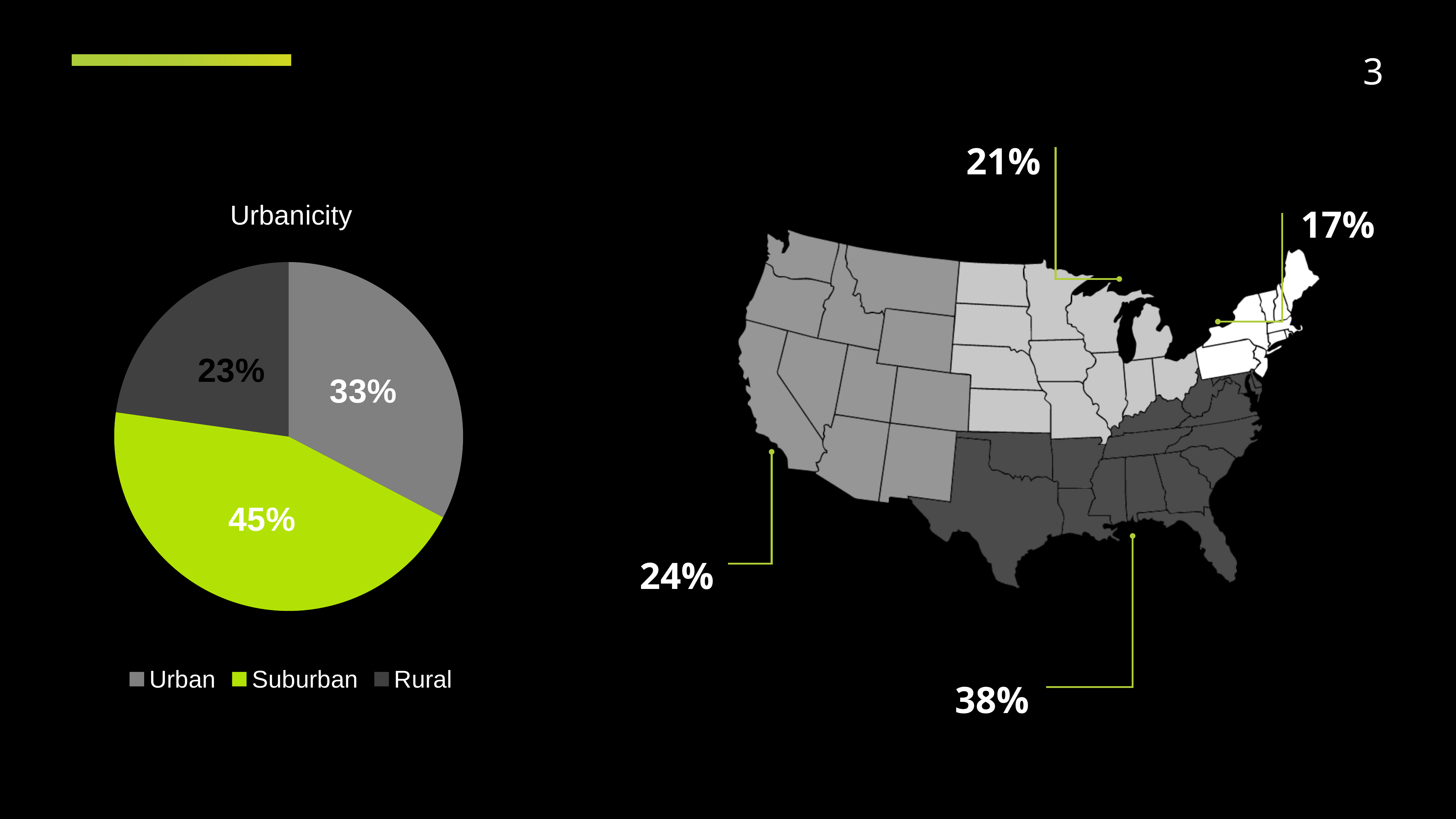
In the Urbanicity pie chart, which category is shown in green? Suburban In the Urbanicity pie chart, what percentage is Rural? 23% In the Urbanicity pie chart, what is the difference in percentage points between Suburban and Urban? 12 In the Urbanicity pie chart, what percentage is Suburban? 45% What type of chart is the Urbanicity chart? Pie chart In the Urbanicity pie chart, which is larger, Urban or Rural? Urban On the map on the right of the slide, what is the highest percentage shown? 38% How many slices does the Urbanicity pie chart have? 3 In the Urbanicity pie chart, what percentage is Urban? 33% In the Urbanicity pie chart, which category has the smallest share? Rural In the Urbanicity pie chart, what is the difference in percentage points between Urban and Rural? 10 In the Urbanicity pie chart, which category has the largest share? Suburban